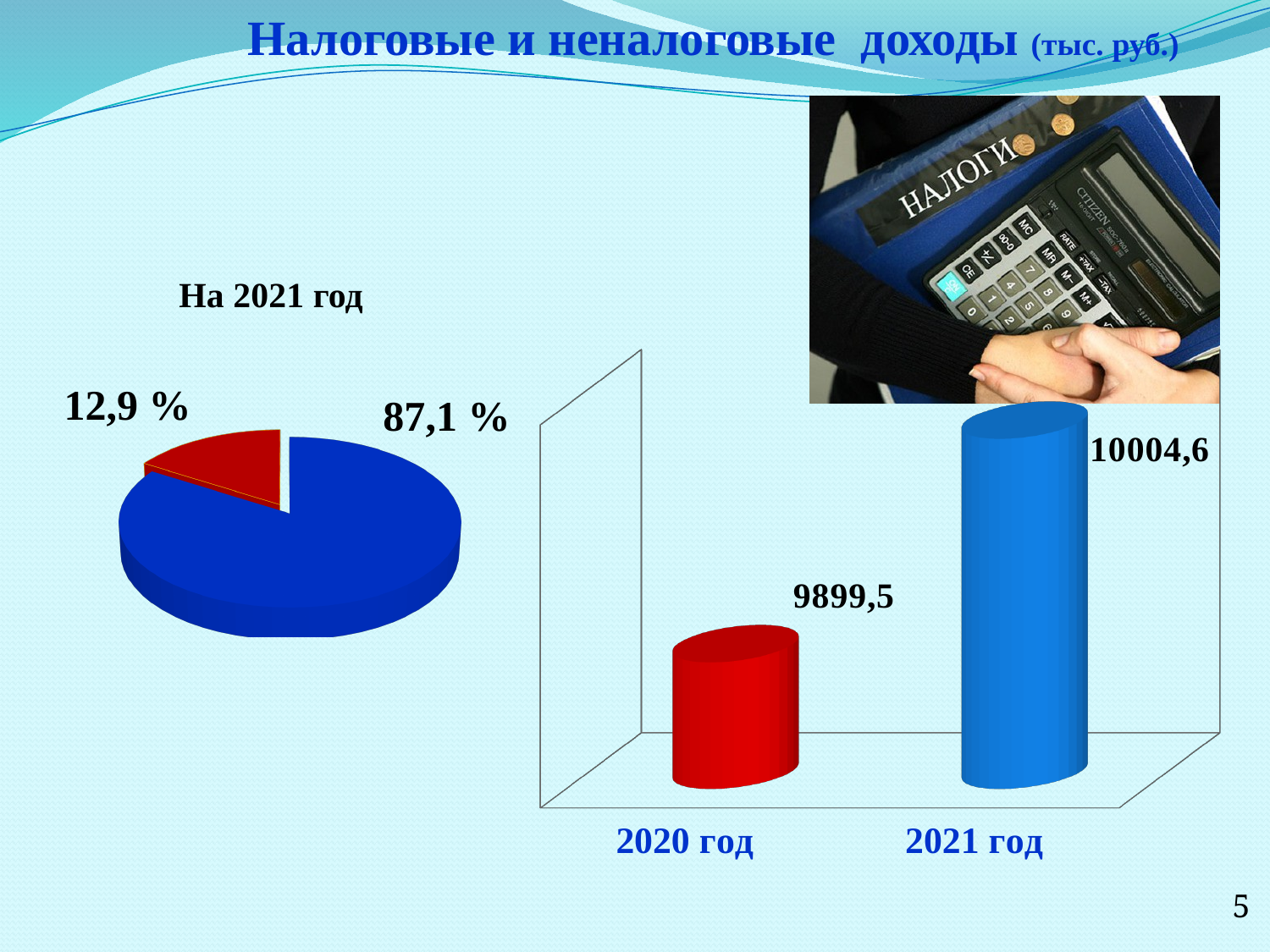
On the bar chart on the right, is the value for 2021 год larger or smaller than the value for 2020 год? larger On the pie chart titled 'На 2021 год', what share does the blue slice represent? 87,1 % On the bar chart on the right, what is the value for 2021 год? 10004,6 On the bar chart on the right, which year has the lower value? 2020 год On the bar chart on the right, which year has the higher value? 2021 год What kind of chart is the chart on the right of the slide? bar chart On the bar chart on the right, what is the difference between the values for 2021 год and 2020 год? 105,1 On the bar chart on the right, what is the value for 2020 год? 9899,5 What kind of chart is the chart titled 'На 2021 год' on the left? pie chart On the pie chart titled 'На 2021 год', what share does the red slice represent? 12,9 % On the bar chart on the right, do the values rise or fall from 2020 год to 2021 год? rise On the bar chart on the right, how many bars are shown? 2